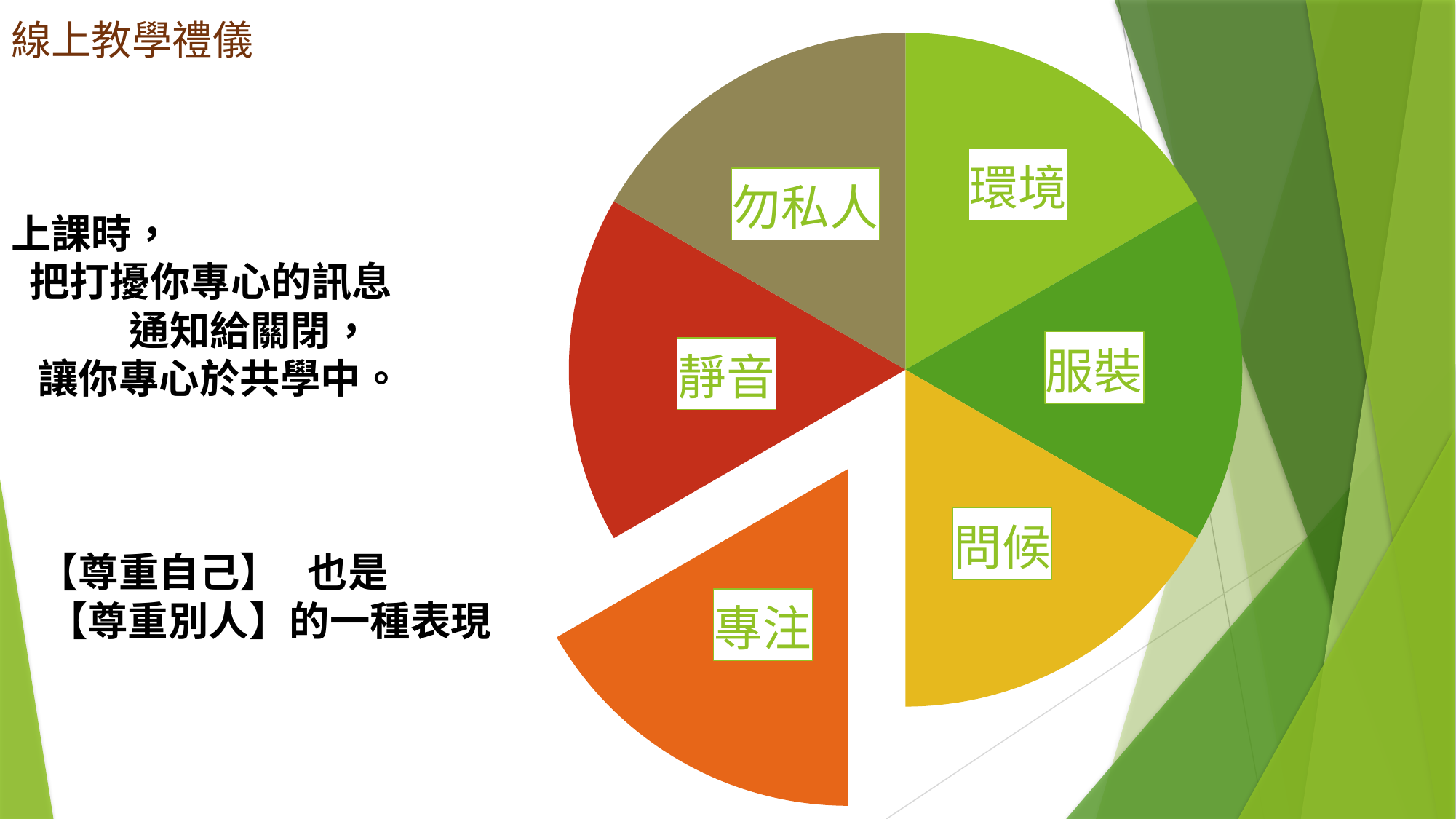
Which slice of the pie chart is coloured yellow? 問候 What colour is the 靜音 slice of the pie chart? red Which slice of the pie chart is labelled 勿私人? the brownish-grey slice at the top left Which slice of the pie chart is coloured orange? 專注 How many slices does the pie chart have? 6 What kind of chart is shown on the slide? pie chart Which slice label sits between 環境 and 問候 going clockwise around the pie chart? 服裝 Which slice of the pie chart is pulled out (exploded) from the rest? 專注